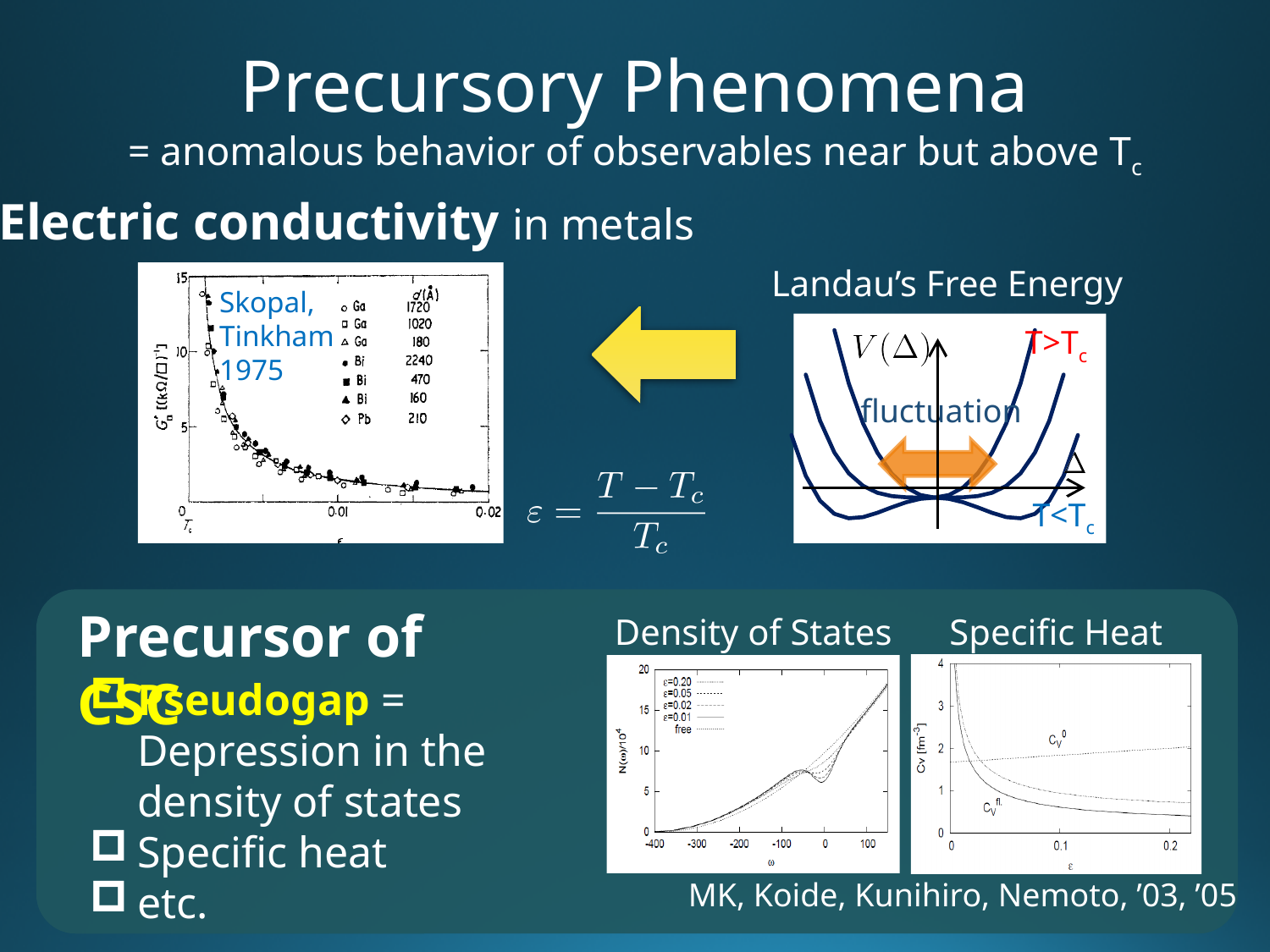
In the Specific Heat chart, is the value of Cv^0 at ε=0.2 greater or less than 1? greater In the Specific Heat chart, is the value of Cv^fl. at ε=0.2 greater or less than 1? less In the electric conductivity chart (Skopal, Tinkham 1975), is the value at ε=0.02 greater or less than 5? less How many series does the legend of the Density of States chart list? 5 In the Specific Heat chart, does the Cv^fl. curve rise or fall as ε increases? fall How many entries does the legend of the electric conductivity chart (Skopal, Tinkham 1975) list? 7 What kind of chart is the Density of States chart? line chart In the Specific Heat chart, which curve is larger at ε=0.1, Cv^0 or Cv^fl.? Cv^0 In the electric conductivity chart (Skopal, Tinkham 1975), does the conductivity rise or fall as ε increases? fall What is the y-axis label of the Specific Heat chart? Cv [fm^-3]